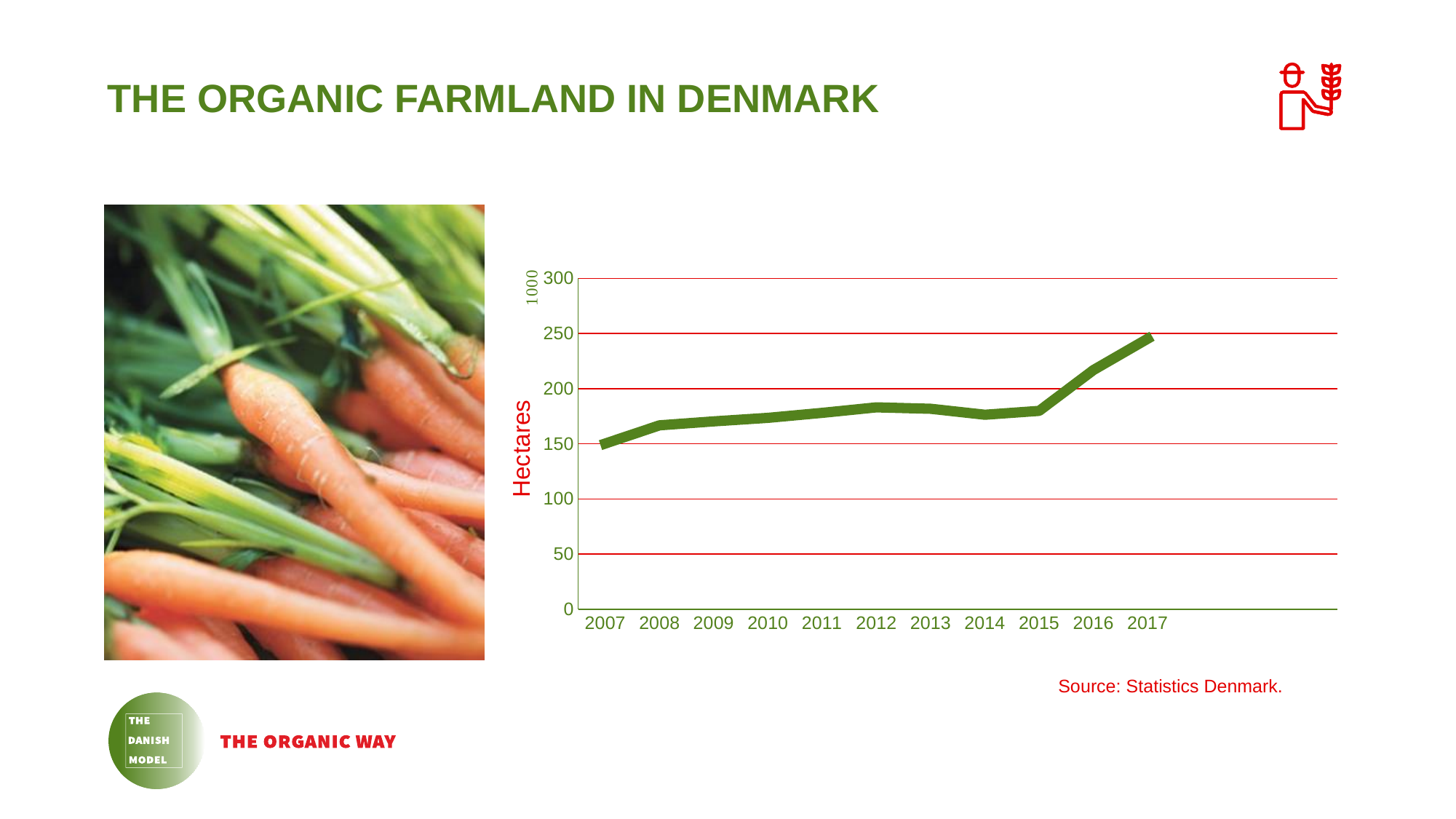
Is the value for 2017 greater or less than 200? greater Is the value for 2007 greater or less than 200? less Overall, do the values rise or fall from 2007 to 2017? rise How many years are plotted along the x axis of the chart? 11 Which year has the highest value in the chart? 2017 What is the label on the y axis of the chart? Hectares Is the value for 2012 greater or less than 150? greater Which year has the larger value, 2016 or 2014? 2016 What is the title of the slide containing the chart? THE ORGANIC FARMLAND IN DENMARK What kind of chart is shown on the slide? line chart Which year has the lowest value in the chart? 2007